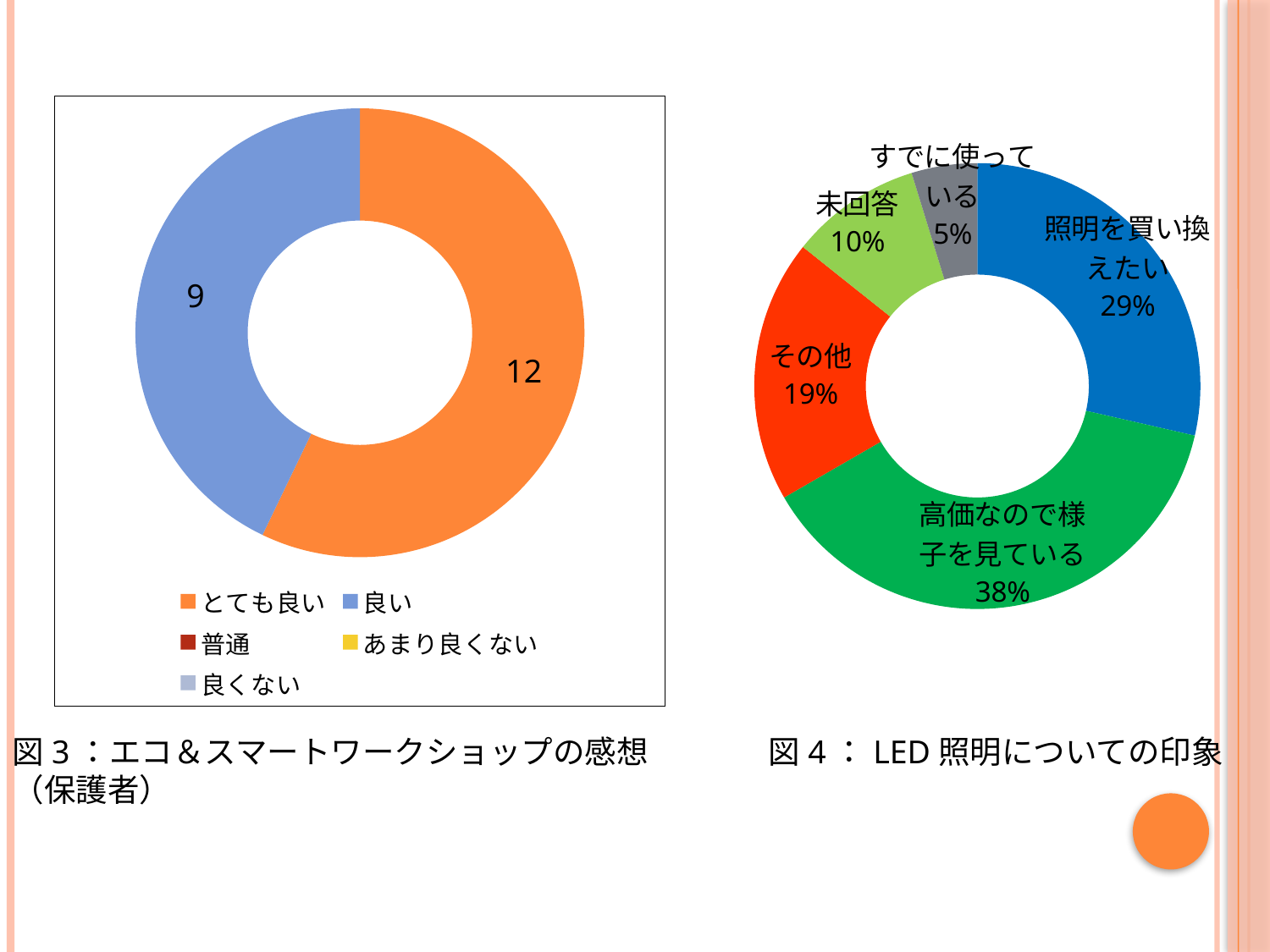
In the right chart (図4), which category has the largest share? 高価なので様子を見ている In the right chart (図4), what share is その他? 19% In the left chart (図3), how many entries does the legend list? 5 In the right chart (図4), how many categories are shown? 5 In the right chart (図4), which category has the smallest share? すでに使っている In the left chart (図3), which is larger, とても良い or 良い? とても良い What kind of chart is the left chart (図3)? Doughnut chart In the left chart (図3), what is the value for 良い? 9 In the right chart (図4), what share is 照明を買い換えたい? 29% In the right chart (図4), what share is 高価なので様子を見ている? 38% In the left chart (図3), what is the difference between the values for とても良い and 良い? 3 In the left chart (図3), what is the value for とても良い? 12